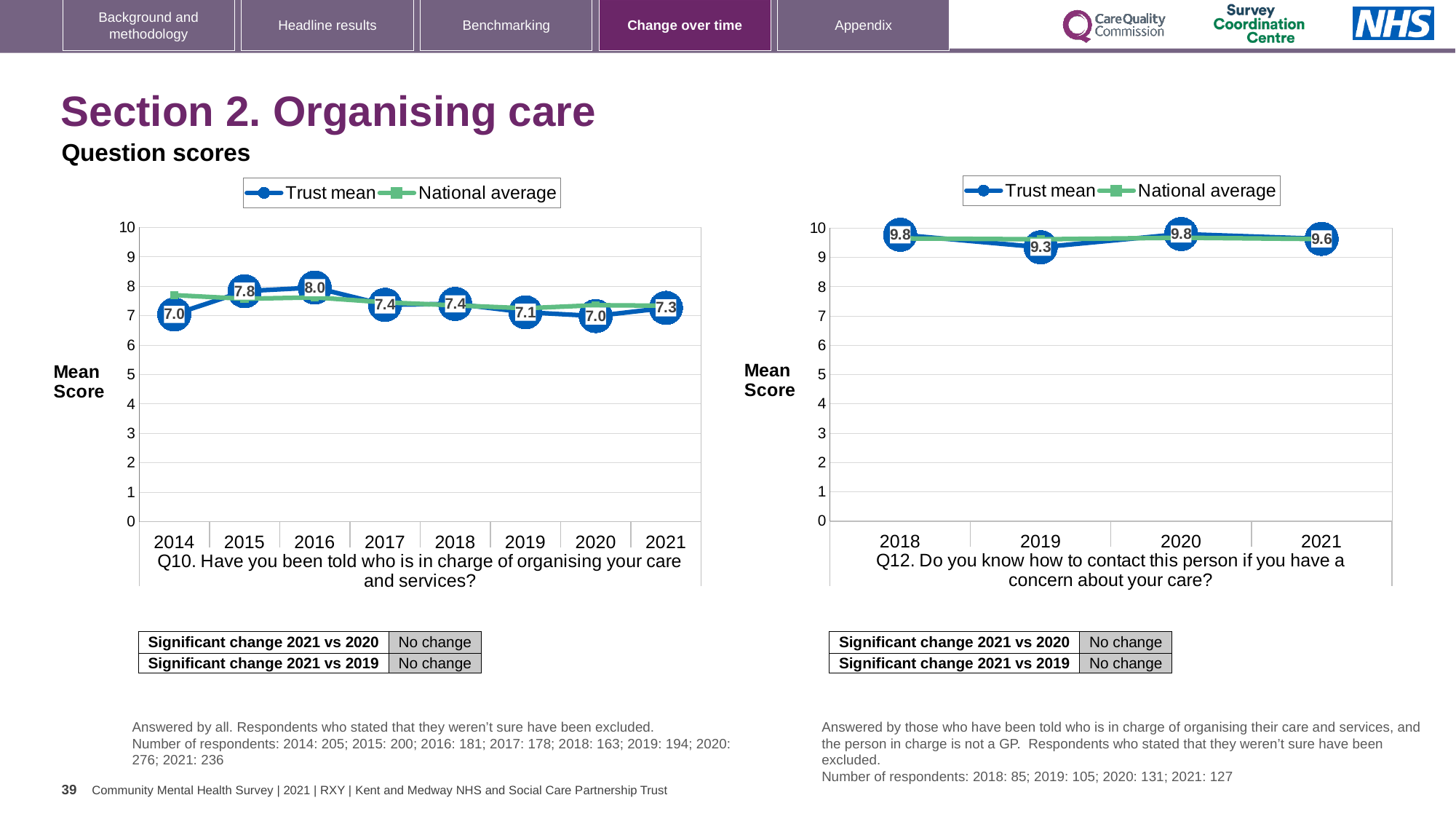
In the Q10 chart on the left, which year has the highest Trust mean score? 2016 In the Q10 chart on the left, what is the difference between the Trust mean scores for 2016 and 2014? 1.0 What type of chart is used for Q10 on the left? Line chart In the Q12 chart on the right, what is the difference between the Trust mean scores for 2018 and 2019? 0.5 In the Q10 chart on the left, is the Trust mean score higher in 2015 or in 2020? 2015 In the Q10 chart on the left, what is the Trust mean score for 2016? 8.0 In the Q12 chart on the right, what is the Trust mean score for 2021? 9.6 How many years are plotted in the Q12 chart on the right? 4 In the Q10 chart on the left, what is the Trust mean score for 2021? 7.3 How many series does the legend of the Q10 chart on the left list? 2 In the Q12 chart on the right, what is the Trust mean score for 2019? 9.3 In the Q12 chart on the right, which year has the lowest Trust mean score? 2019